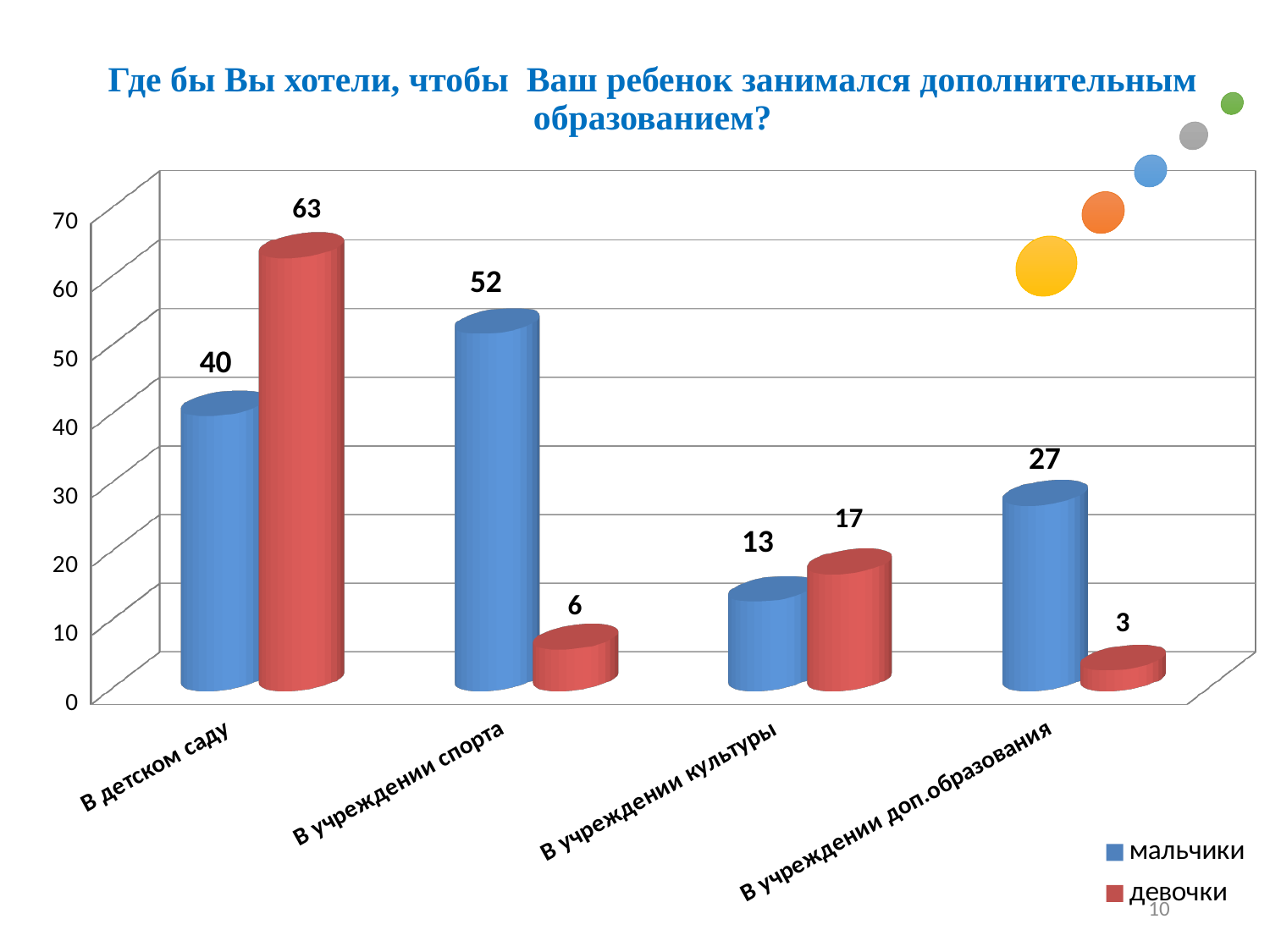
Which category has the lowest value for мальчики? В учреждении культуры How many series does the legend list? 2 How many categories are shown on the x axis? 4 Which category has the highest value for девочки? В детском саду What is the difference between the мальчики and девочки values in the category В учреждении спорта? 46 In the category В учреждении культуры, which series has the larger value, мальчики or девочки? девочки What kind of chart is shown on the slide? bar chart What is the value for девочки in the category В учреждении спорта? 6 What colour are the bars for the series девочки? red What is the value for мальчики in the category В детском саду? 40 What is the difference between the девочки and мальчики values in the category В детском саду? 23 What is the value for девочки in the category В учреждении доп.образования? 3